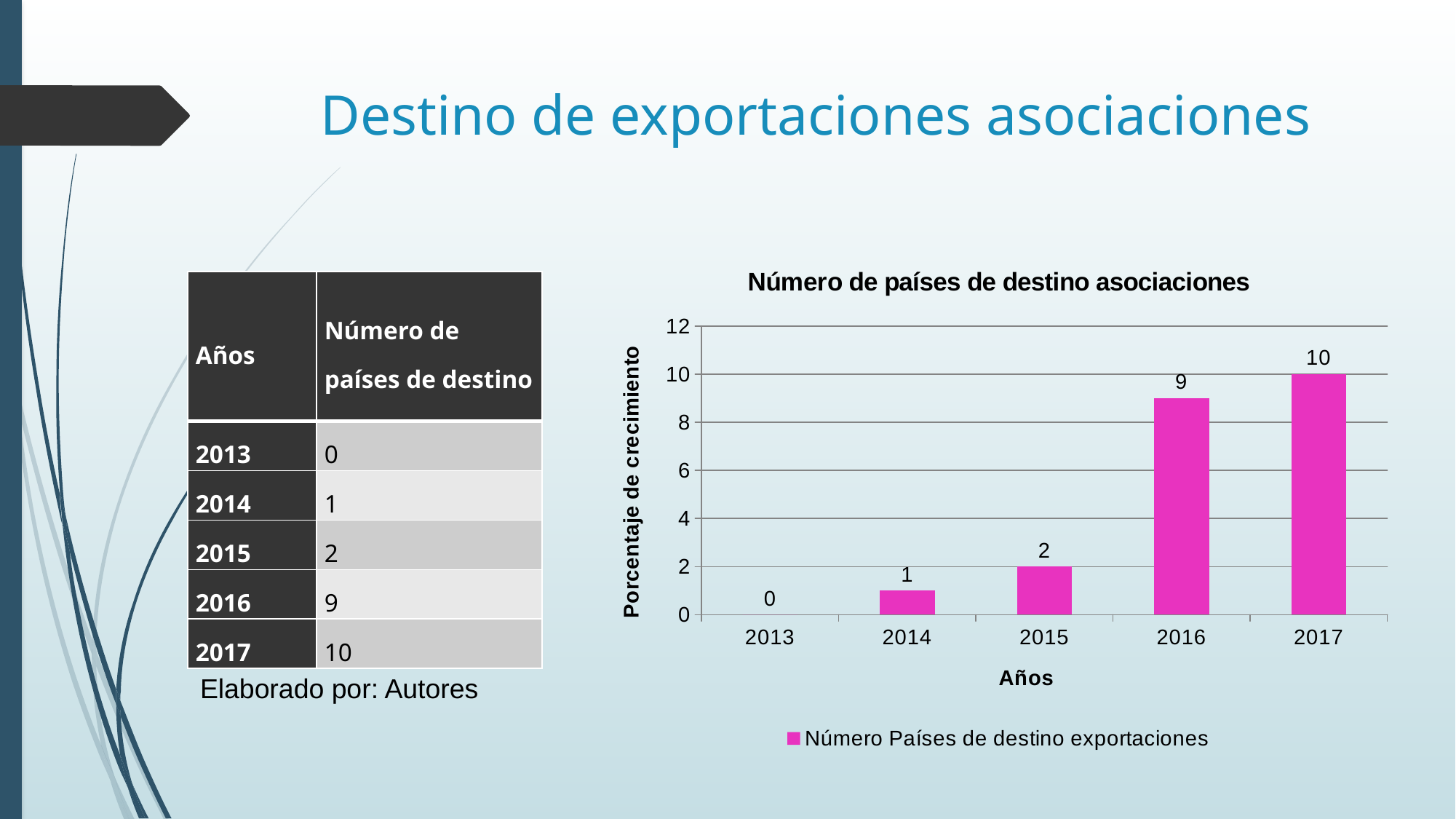
How many years are shown on the x axis of the chart? 5 What is the difference between the values for 2016 and 2015? 7 Which year has the highest value in the chart? 2017 Which is larger, the value for 2015 or the value for 2016? 2016 How many series does the legend list? 1 What is the value for 2014 in the chart? 1 What is the value for 2013 in the chart? 0 Which year has the lowest value in the chart? 2013 Do the values rise or fall from 2013 to 2017? rise What is the difference between the values for 2017 and 2016? 1 What is the value for 2016 in the chart? 9 What kind of chart is shown on the slide? bar chart